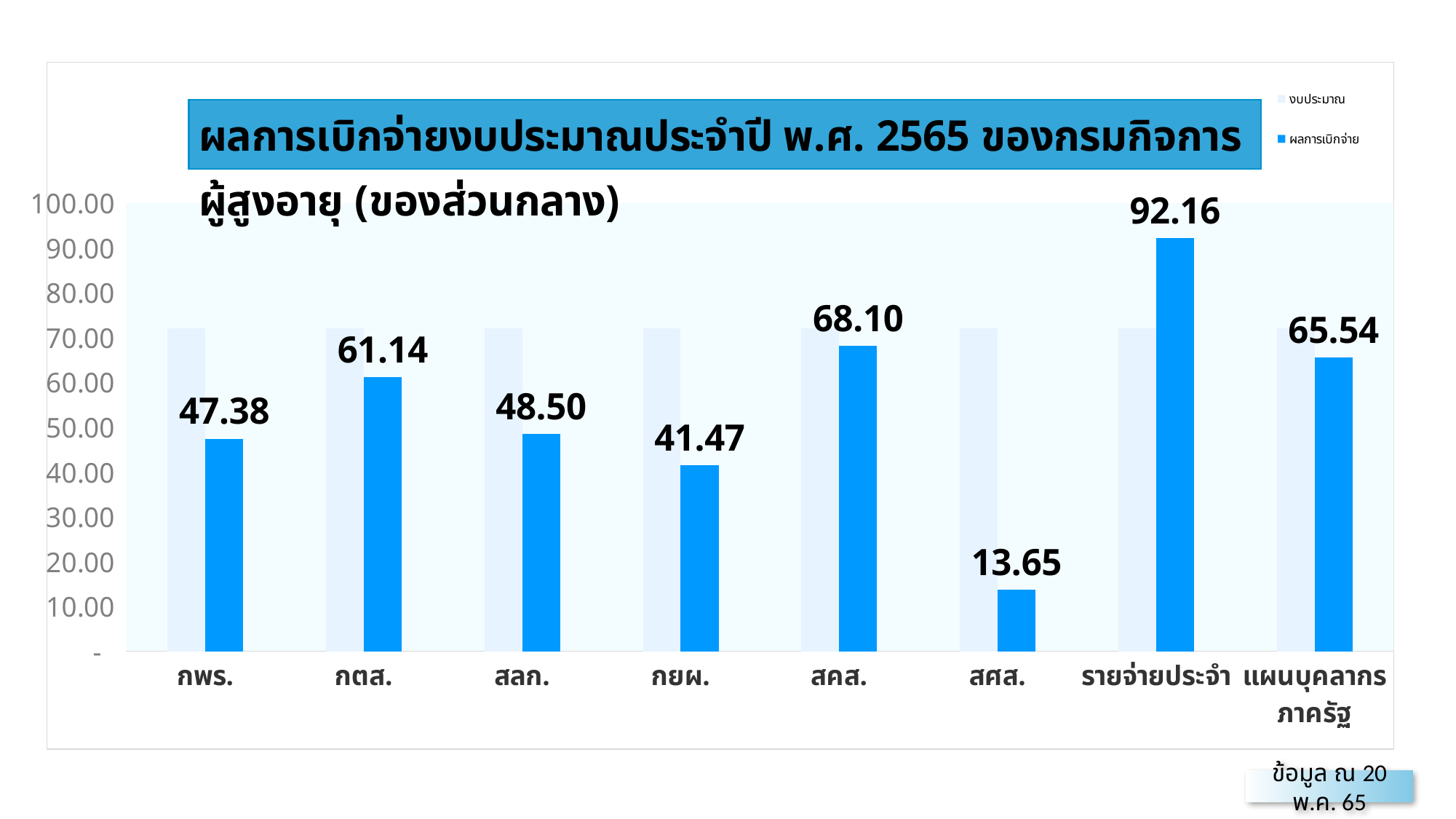
Which has a larger ผลการเบิกจ่าย value, กพร. or สลก.? สลก. What is the ผลการเบิกจ่าย value for สศส.? 13.65 What is the difference between the ผลการเบิกจ่าย values for สคส. and กตส.? 6.96 How many categories are shown on the x axis? 8 What are the two series named in the legend? งบประมาณ and ผลการเบิกจ่าย What is the ผลการเบิกจ่าย value for รายจ่ายประจำ? 92.16 Is the งบประมาณ value for กพร. greater or less than 60.00? greater Which category has the lowest ผลการเบิกจ่าย value? สศส. How many series does the legend list? 2 What is the ผลการเบิกจ่าย value for กยผ.? 41.47 Which category has the highest ผลการเบิกจ่าย value? รายจ่ายประจำ What kind of chart is shown on the slide? bar chart